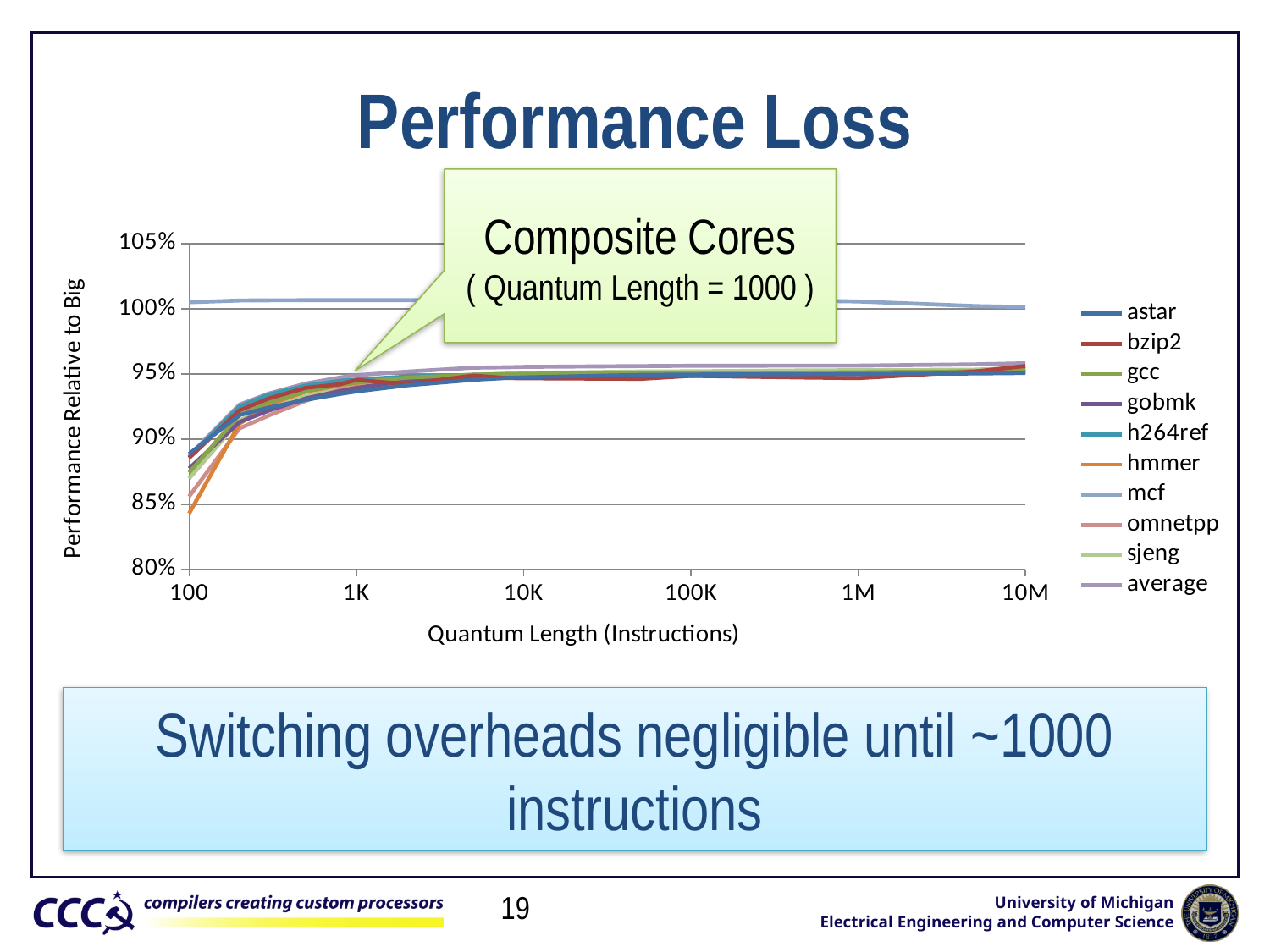
How many series does the legend list? 10 What is the title of the chart's y axis? Performance Relative to Big Is the value for astar at a quantum length of 10M greater or less than 90%? greater Is the value for mcf at a quantum length of 100 greater or less than 100%? greater Is the value for astar at a quantum length of 100 greater or less than 90%? less Which series has the lowest value at a quantum length of 100? hmmer What is the title of the chart's x axis? Quantum Length (Instructions) How many labelled tick marks are on the x axis? 6 Do the values for astar rise or fall as quantum length increases from 100 to 1K? rise What kind of chart is shown on the slide? line chart Which series has the highest value at a quantum length of 100? mcf At a quantum length of 10M, which is larger: the value for mcf or the value for astar? mcf